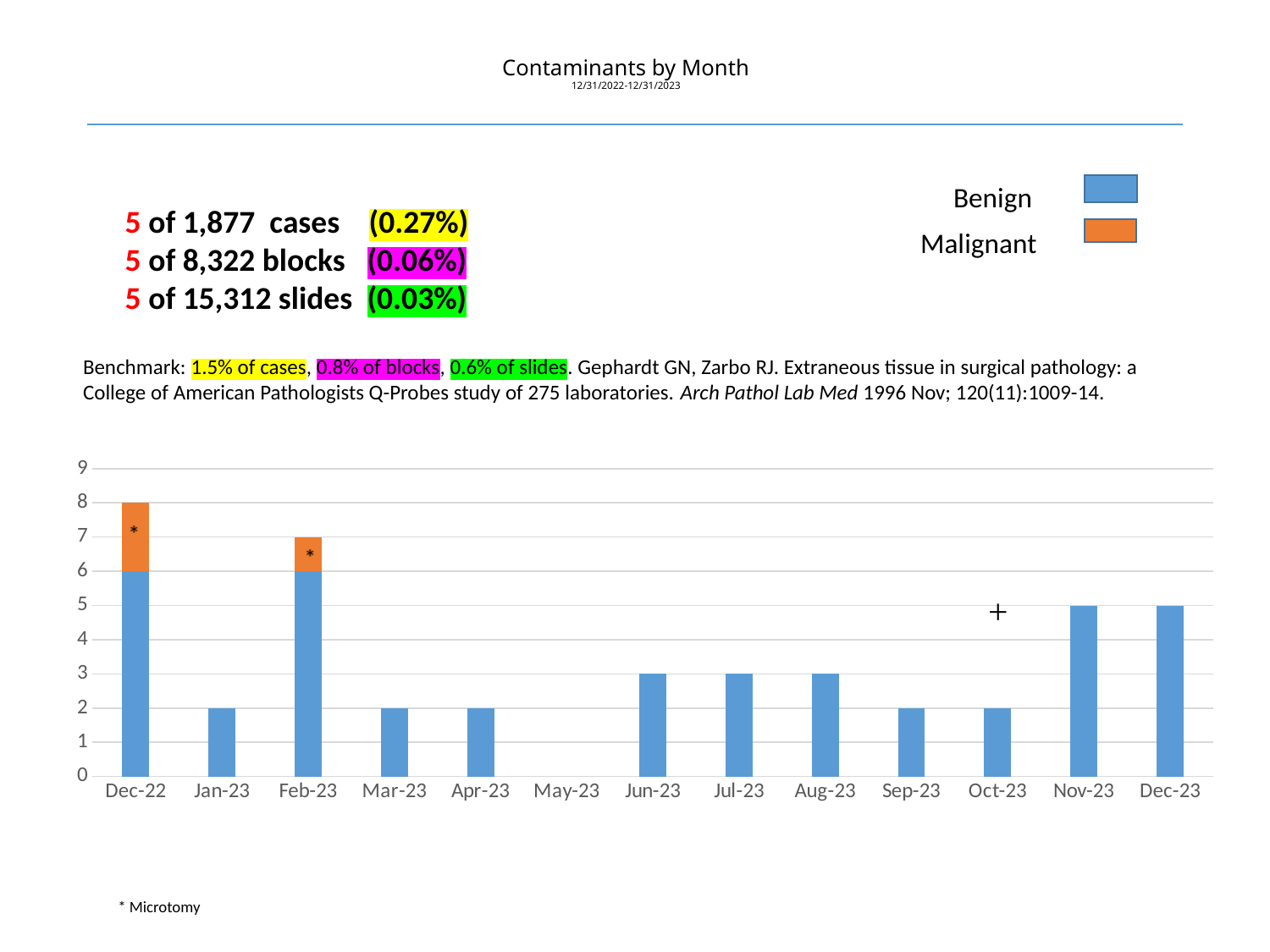
Which month has no bar at all in the chart? May-23 What is the total height of the stacked bar for Feb-23? 7 How many months are shown on the x axis of the chart? 13 What type of chart is shown on the slide? Stacked bar chart What is the title of the chart? Contaminants by Month How many series does the legend list? 2 What is the Benign value for Feb-23? 6 What is the total height of the stacked bar for Dec-22? 8 What is the value for Nov-23? 5 What is the difference between the total for Dec-22 and the value for Dec-23? 3 Which month has the highest total bar in the chart? Dec-22 Which is larger, the value for Jun-23 or the value for Sep-23? Jun-23